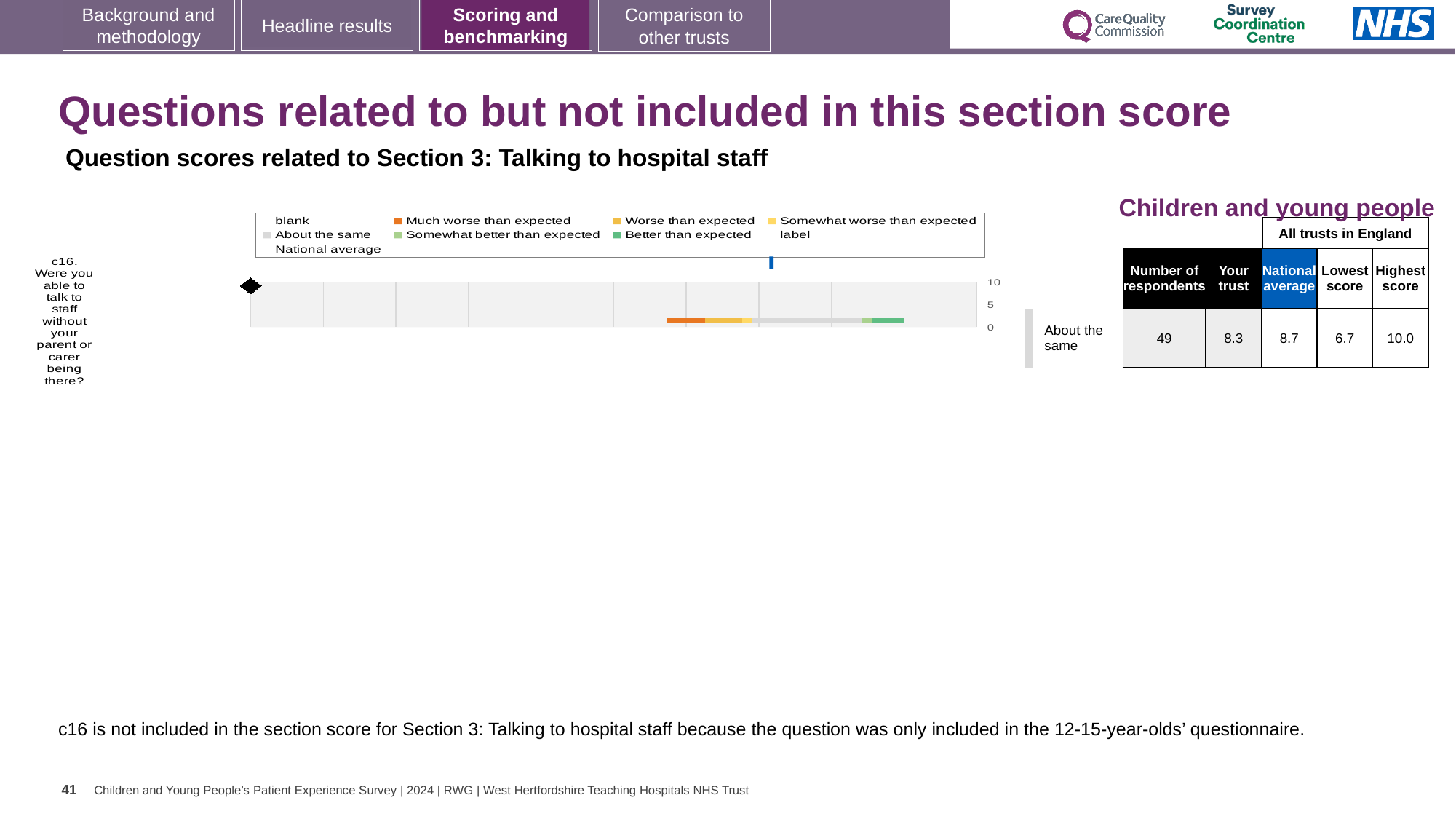
What is the highest score among all trusts in England for c16? 10.0 What is the lowest score among all trusts in England for c16? 6.7 What kind of chart is used to show the c16 question score? bar chart Which benchmark band is the trust's c16 score placed in? About the same How many survey questions are plotted in the chart? 1 What is the difference between the highest and lowest scores for c16 across all trusts in England? 3.3 Which is larger for c16: the trust's score or the national average? National average What is the difference between the national average and the trust's score for c16? 0.4 What is the national average score for c16? 8.7 What is the 'Your trust' score for c16? 8.3 How many respondents answered c16 for this trust? 49 Which legend entry is shown in orange in the chart? Much worse than expected